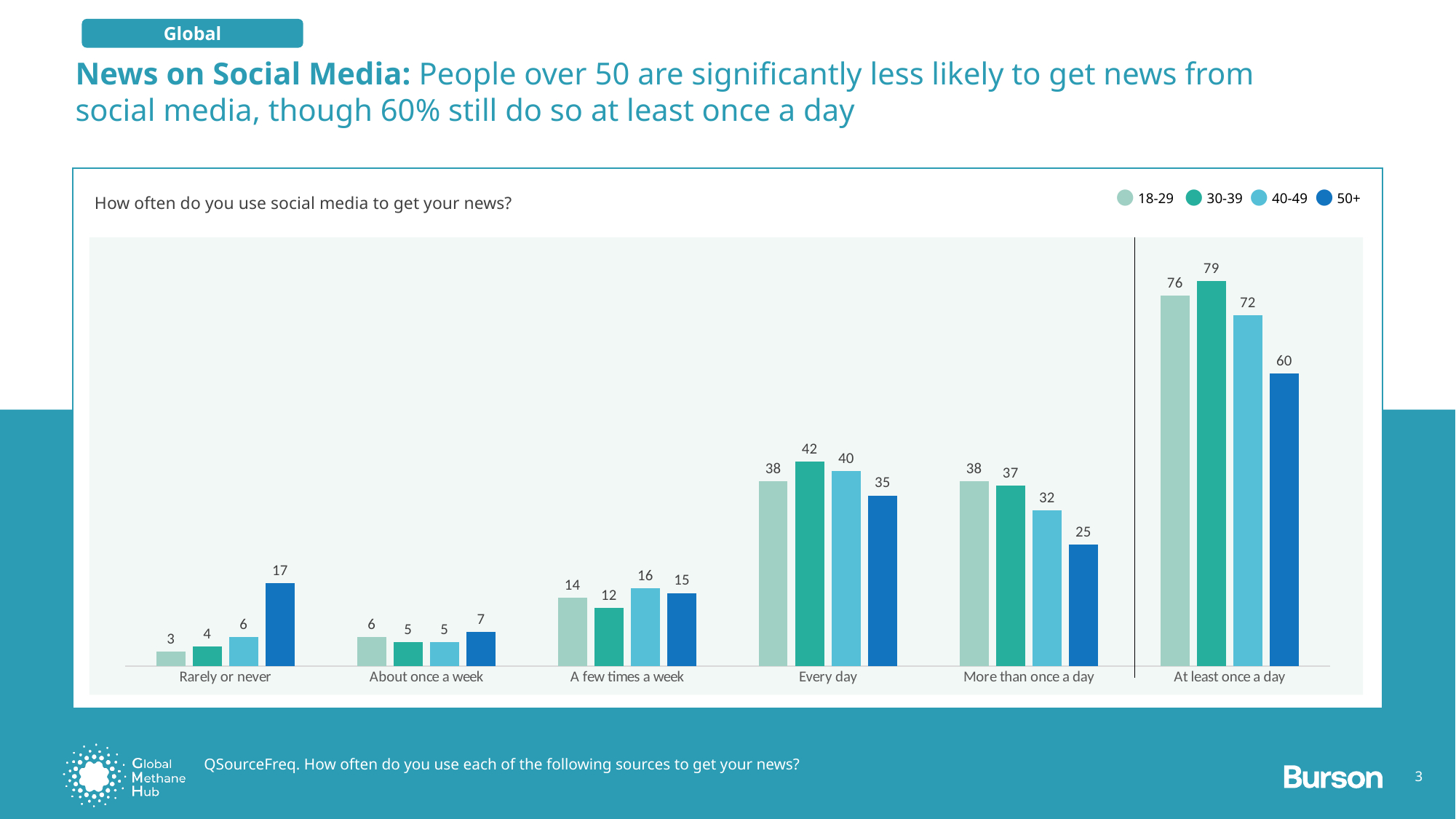
What is the value for the 18-29 group in the 'Every day' category? 38 What is the value for the 40-49 group in the 'More than once a day' category? 32 What is the difference between the 30-39 and 50+ values in the 'Every day' category? 7 In the 'A few times a week' category, which is larger: the value for 18-29 or the value for 30-39? 18-29 What kind of chart is shown on the slide? Bar chart What is the value for the 50+ group in the 'At least once a day' category? 60 What question is the chart based on, as shown above the chart? How often do you use social media to get your news? Which age group has the lowest value in the 'At least once a day' category? 50+ How many frequency categories are shown on the x axis? 6 How many age groups does the legend list? 4 Which age group has the highest value in the 'Rarely or never' category? 50+ What is the difference between the 30-39 and 50+ values in the 'At least once a day' category? 19